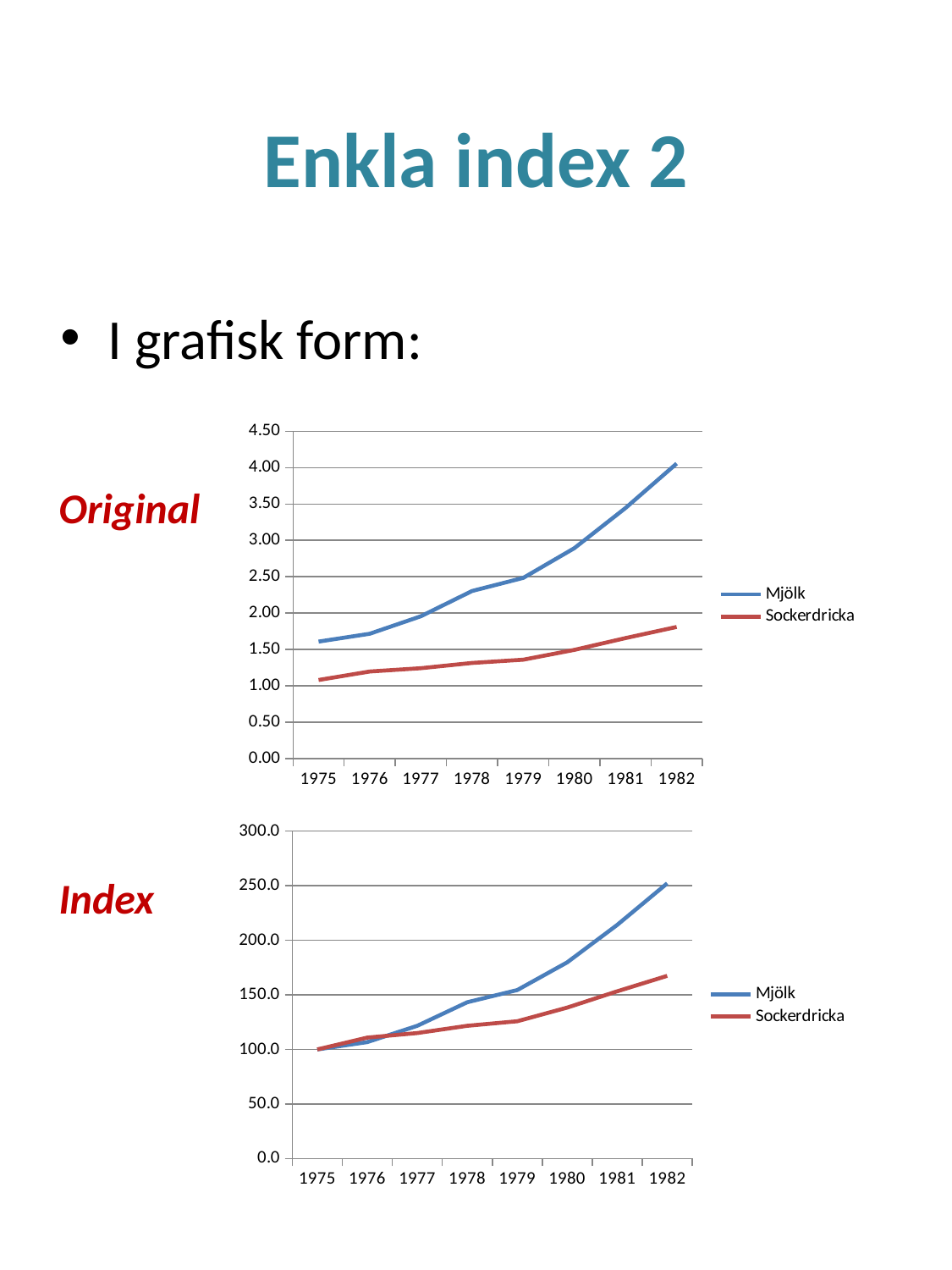
In the top chart labelled Original, which series has the higher value in 1982, Mjölk or Sockerdricka? Mjölk In the bottom chart labelled Index, is the value for Sockerdricka in 1982 greater or less than 200.0? less In the bottom chart labelled Index, what is the value for Mjölk in 1975? 100.0 What kind of chart is the top chart labelled Original? line chart How many years are shown on the x axis of the top chart labelled Original? 8 What colour is the Sockerdricka line in the top chart labelled Original? red In the top chart labelled Original, is the value for Sockerdricka in 1982 greater or less than 2.00? less In the bottom chart labelled Index, do the values for Mjölk rise or fall from 1975 to 1982? rise In the top chart labelled Original, is the value for Mjölk in 1975 greater or less than 1.50? greater In the bottom chart labelled Index, what is the value for Sockerdricka in 1975? 100.0 How many series does the legend of the bottom chart labelled Index list? 2